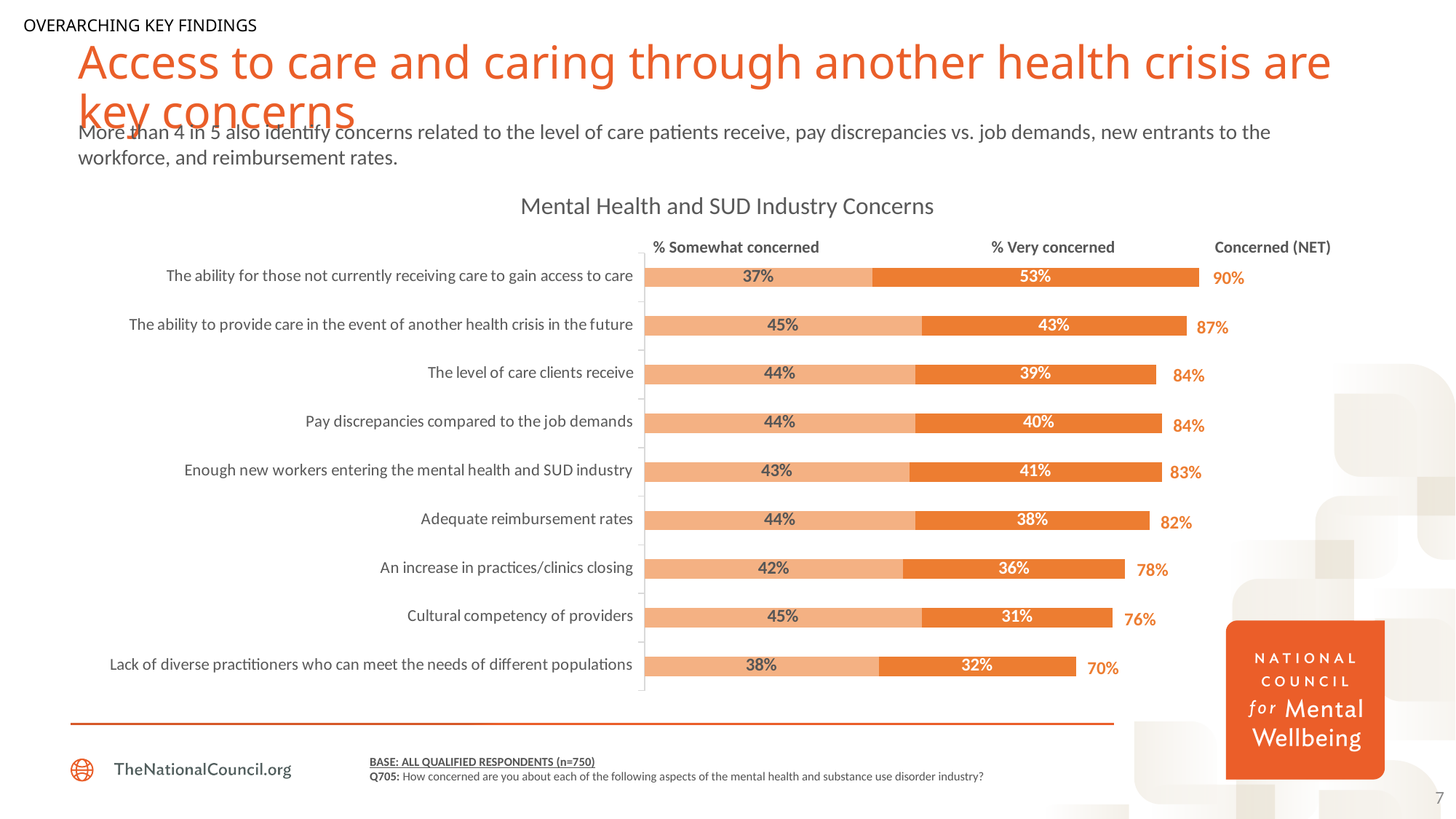
Which is larger: the % Very concerned value for 'Pay discrepancies compared to the job demands' or for 'Enough new workers entering the mental health and SUD industry'? Enough new workers entering the mental health and SUD industry How many concern categories are plotted in the chart? 9 What is the % Somewhat concerned value for 'Cultural competency of providers'? 45% Which category has the lowest % Very concerned value? Cultural competency of providers What is the title of the chart? Mental Health and SUD Industry Concerns What is the difference between the % Very concerned values for 'The level of care clients receive' and 'An increase in practices/clinics closing'? 3% What is the % Very concerned value for 'The ability for those not currently receiving care to gain access to care'? 53% What is the total Concerned (NET) for 'Lack of diverse practitioners who can meet the needs of different populations'? 70% What are the two series shown in the stacked bars? % Somewhat concerned and % Very concerned Which category has the highest Concerned (NET) value? The ability for those not currently receiving care to gain access to care What type of chart is shown on the slide? Stacked bar chart What is the Concerned (NET) value for 'Adequate reimbursement rates'? 82%